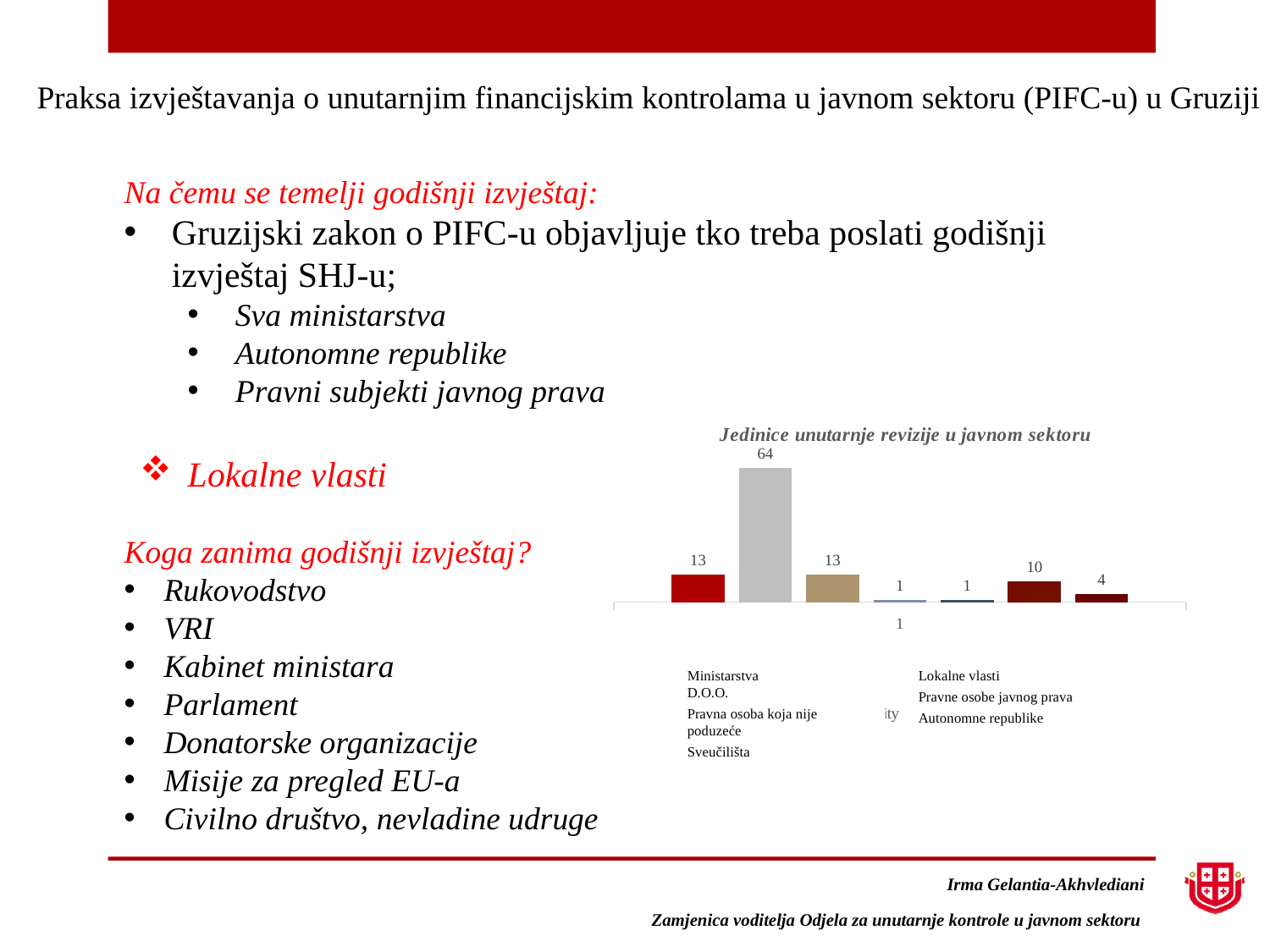
What is the value of the second bar from the left in the chart? 64 Which is larger, the sixth bar from the left or the rightmost bar? the sixth bar (10) What is the difference between the tallest bar (64) and the leftmost bar (13)? 51 How many bars in the chart have a value of 1? 2 What is the title of the chart on the slide? Jedinice unutarnje revizije u javnom sektoru What is the value of the rightmost bar in the chart? 4 How many bars are plotted in the chart? 7 What is the difference between the sixth bar (10) and the seventh bar (4)? 6 What is the value of the leftmost bar in the chart? 13 What kind of chart is shown on the slide? bar chart What is the highest value shown in the chart? 64 What is the lowest value shown in the chart? 1